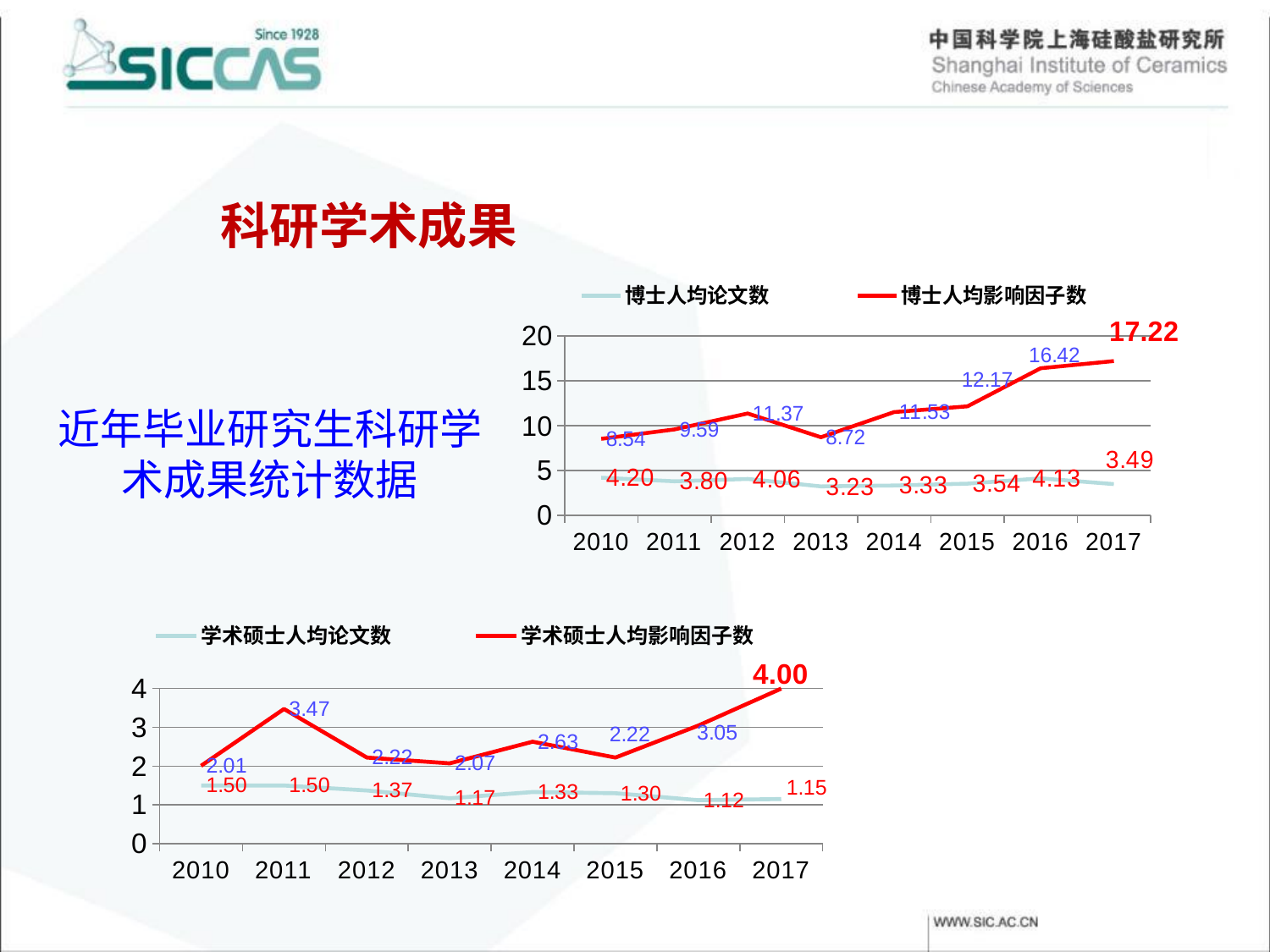
How many years are shown on the x axis of the bottom-left chart? 8 In the bottom-left chart, what is the value of 学术硕士人均论文数 in 2016? 1.12 In the top-right chart, is the 博士人均影响因子数 value for 2015 greater or less than 10? greater In the top-right chart, what is the difference between the 博士人均影响因子数 values for 2017 and 2016? 0.80 In the top-right chart, what is the value of 博士人均论文数 in 2013? 3.23 In the top-right chart, which year has the lowest value for 博士人均影响因子数? 2010 In the bottom-left chart, which is larger: the 学术硕士人均论文数 value for 2010 or for 2013? 2010 In the bottom-left chart, what is the value of 学术硕士人均影响因子数 in 2011? 3.47 In the bottom-left chart, which year has the highest value for 学术硕士人均影响因子数? 2017 How many series does the legend of the top-right chart list? 2 In the top-right chart, what is the value of 博士人均影响因子数 in 2017? 17.22 What type of chart is the bottom-left chart? Line chart